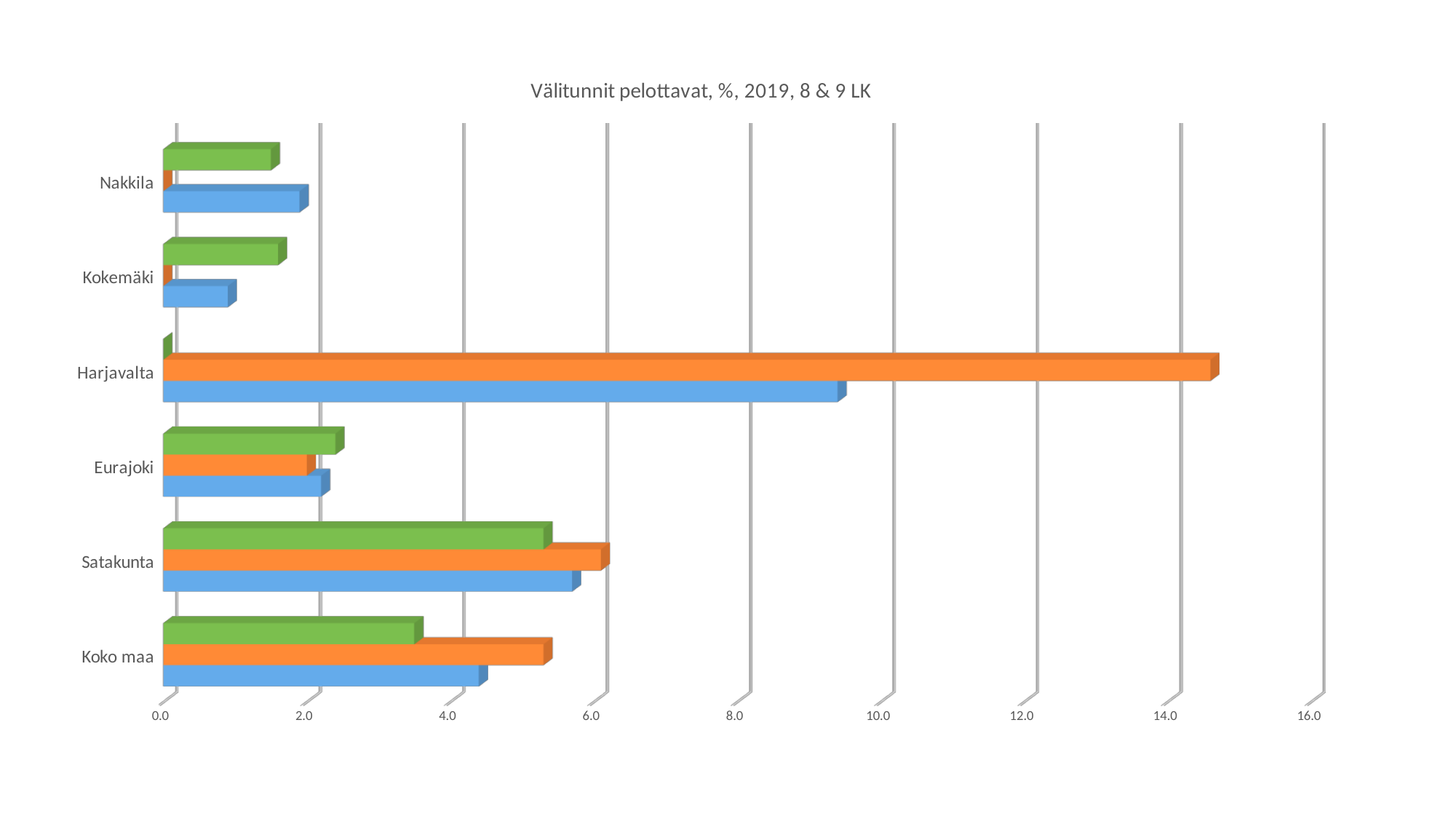
For Koko maa, which is larger: the orange bar or the blue bar? the orange bar Is the green bar for Satakunta greater or less than 4.0? greater Which category has the longest blue bar? Harjavalta Is the blue bar for Kokemäki greater or less than 2.0? less Which category has the longest orange bar? Harjavalta Which category has the longest green bar? Satakunta What is the title of the chart? Välitunnit pelottavat, %, 2019, 8 & 9 LK How many categories are shown on the vertical axis of the chart? 6 Which category has the shortest green bar? Harjavalta Is the orange bar for Harjavalta greater or less than 14.0? greater What kind of chart is shown on the slide? bar chart